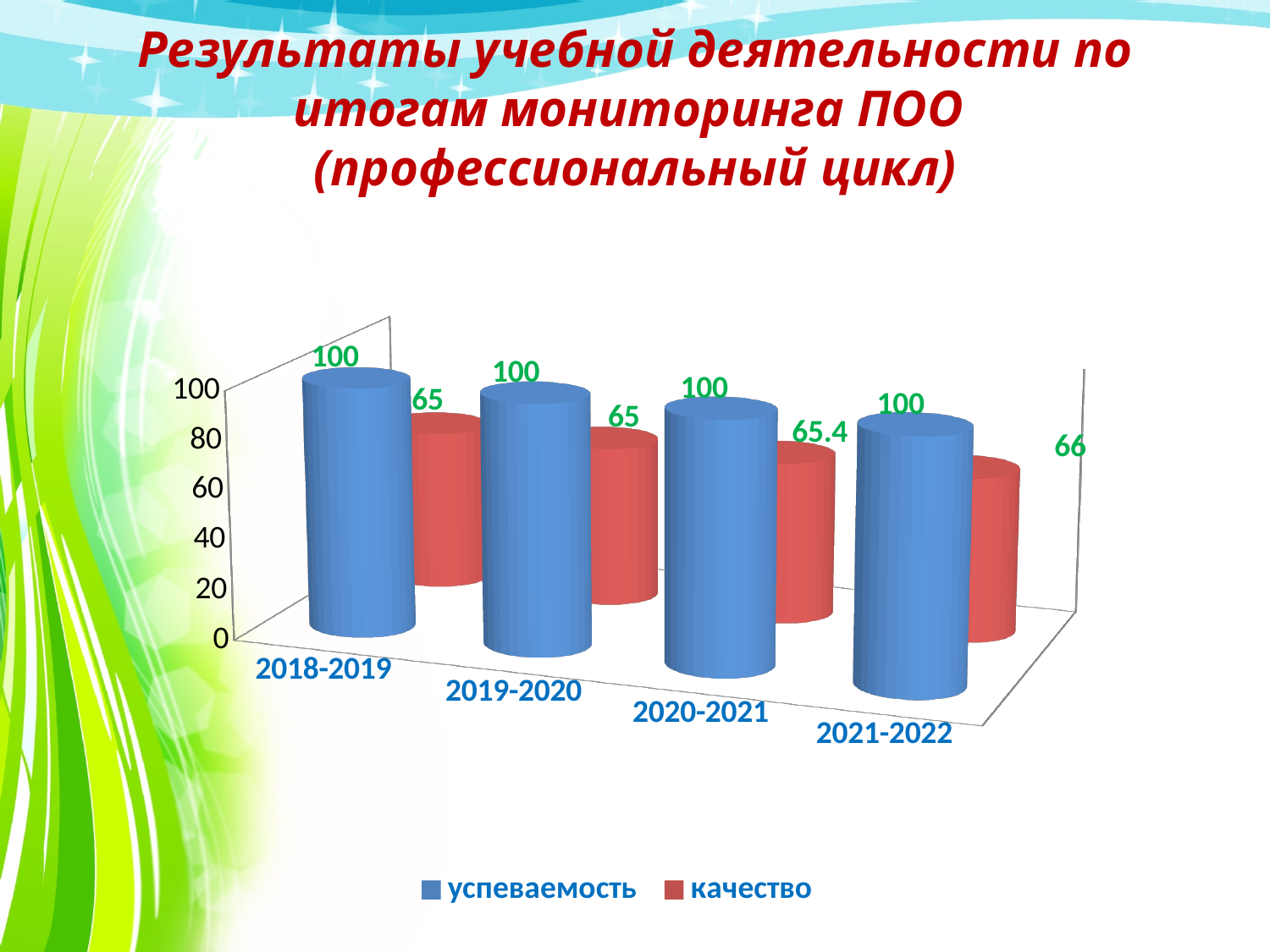
What kind of chart is shown on the slide? bar chart What is the value of качество for 2020-2021? 65.4 Which year has the highest value for качество? 2021-2022 What is the difference between успеваемость and качество for 2018-2019? 35 How many academic years are shown on the x axis? 4 Which is larger for 2020-2021: успеваемость or качество? успеваемость What is the difference between качество for 2021-2022 and качество for 2019-2020? 1 What is the value of успеваемость for 2018-2019? 100 What is the value of качество for 2021-2022? 66 What is the value of качество for 2019-2020? 65 How many series does the legend list? 2 Does the value of качество rise or fall from 2019-2020 to 2021-2022? rise